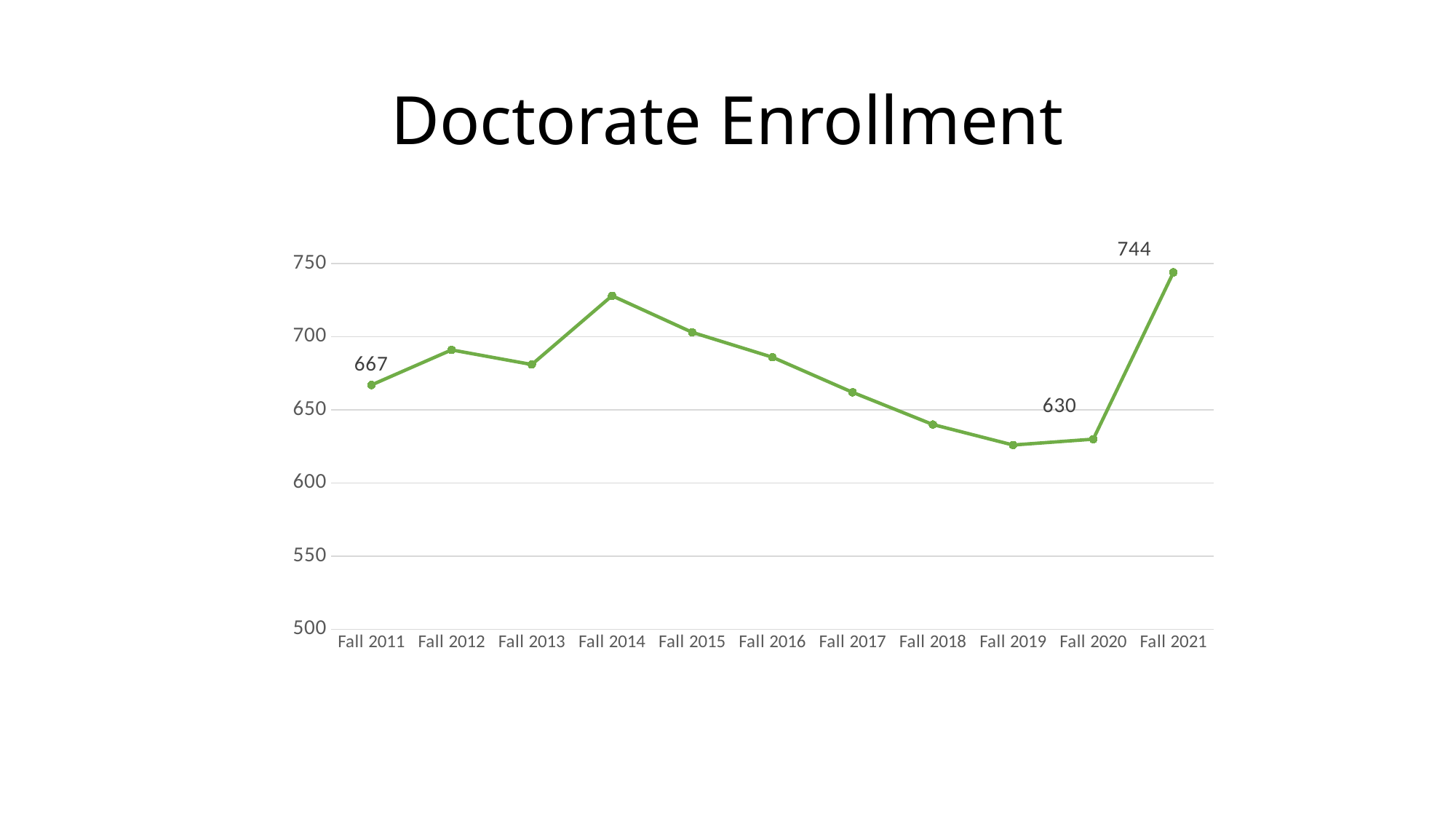
What is the difference between the Fall 2021 and Fall 2011 enrollment values? 77 Which has the higher enrollment, Fall 2014 or Fall 2013? Fall 2014 Which term has the highest doctorate enrollment? Fall 2021 What is the doctorate enrollment value for Fall 2020? 630 How many terms are plotted on the x axis? 11 What kind of chart is shown on the slide? line chart What is the doctorate enrollment value for Fall 2011? 667 Do the values rise or fall from Fall 2014 to Fall 2019? fall What is the doctorate enrollment value for Fall 2021? 744 Is the value for Fall 2018 greater or less than 650? less Is the value for Fall 2014 greater or less than 700? greater What is the difference between the Fall 2021 and Fall 2020 enrollment values? 114